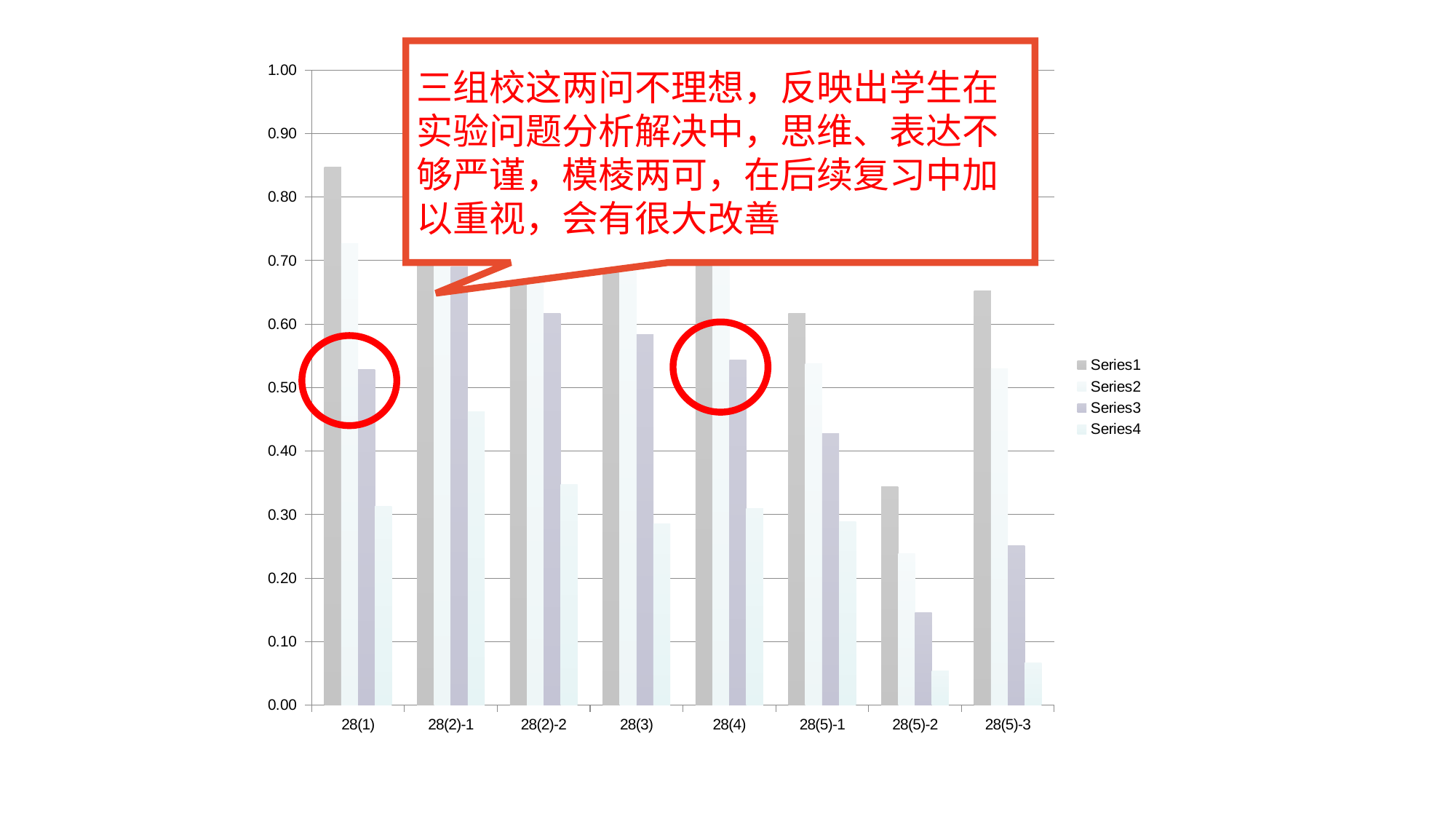
Which is larger, the Series3 value for 28(5)-1 or the Series3 value for 28(5)-3? 28(5)-1 Is the Series3 value for 28(5)-2 greater or less than 0.20? less Is the Series4 value for 28(5)-3 greater or less than 0.10? less Is the Series1 value for 28(5)-2 greater or less than 0.40? less How many series does the legend list? 4 What is the label of the first entry in the legend? Series1 Which is larger, the Series1 value for 28(1) or the Series1 value for 28(5)-3? 28(1) How many categories are shown on the x axis? 8 What kind of chart is shown on the slide? bar chart Which category has the lowest Series3 value? 28(5)-2 Which category has the lowest Series1 value? 28(5)-2